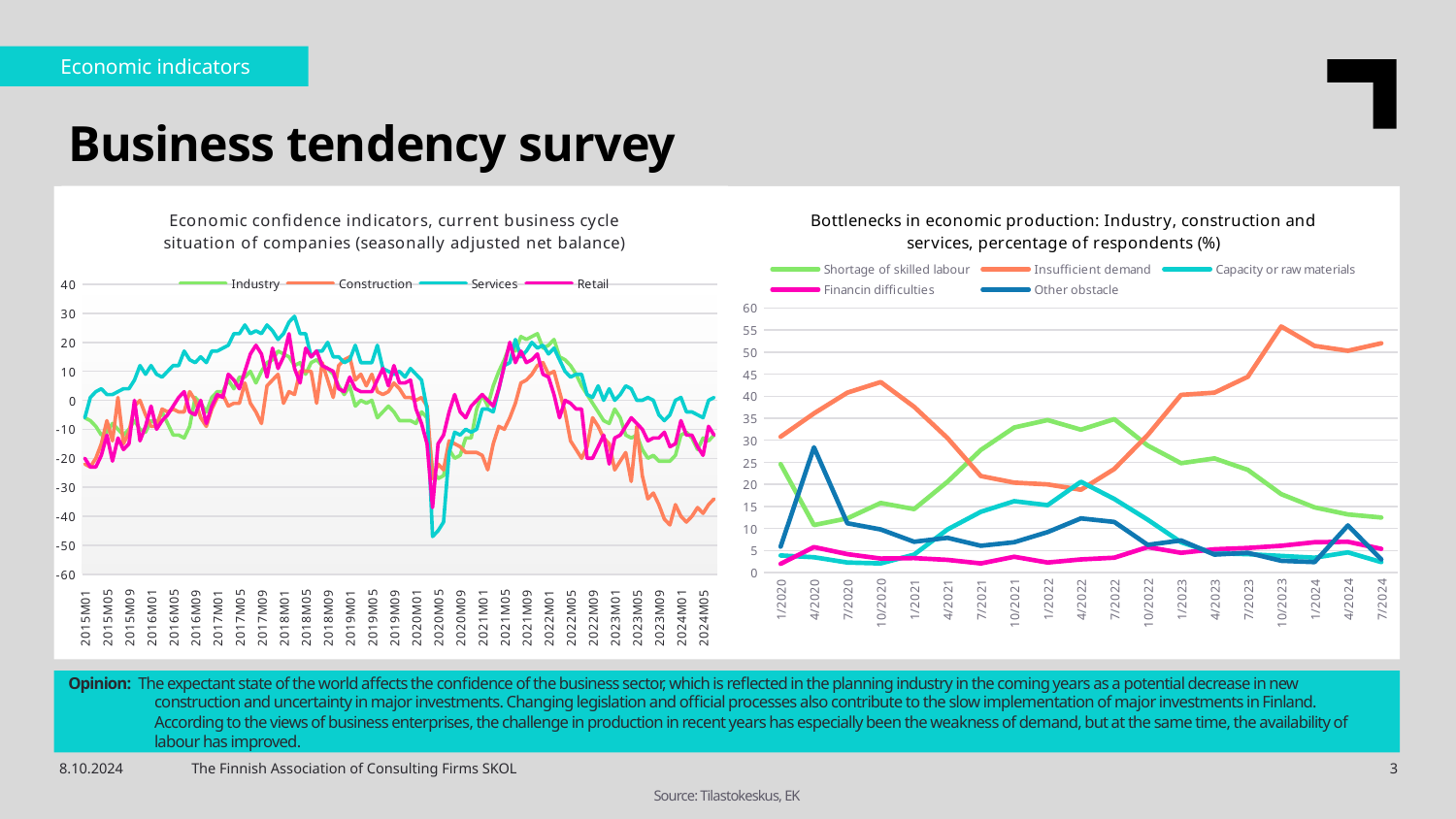
How many time points are labelled on the x axis of the right chart (Bottlenecks in economic production)? 19 In the right chart (Bottlenecks in economic production), which series has the highest value at 10/2023? Insufficient demand In the right chart (Bottlenecks in economic production), is the value for Shortage of skilled labour at 7/2024 greater or less than 15? less In the right chart (Bottlenecks in economic production), which is larger at 7/2024: Insufficient demand or Shortage of skilled labour? Insufficient demand In the left chart (Economic confidence indicators), is the value for Construction at 2020M05 greater or less than -40? greater In the left chart (Economic confidence indicators), is the value for Construction at 2024M05 greater or less than -30? less In the right chart (Bottlenecks in economic production), does the Insufficient demand series rise or fall between 1/2023 and 10/2023? rise In the left chart (Economic confidence indicators), which series has the lowest value around 2020M05? Services What kind of chart is the left chart, 'Economic confidence indicators, current business cycle situation of companies'? line chart How many series does the legend of the right chart (Bottlenecks in economic production) list? 5 How many series does the legend of the left chart (Economic confidence indicators) list? 4